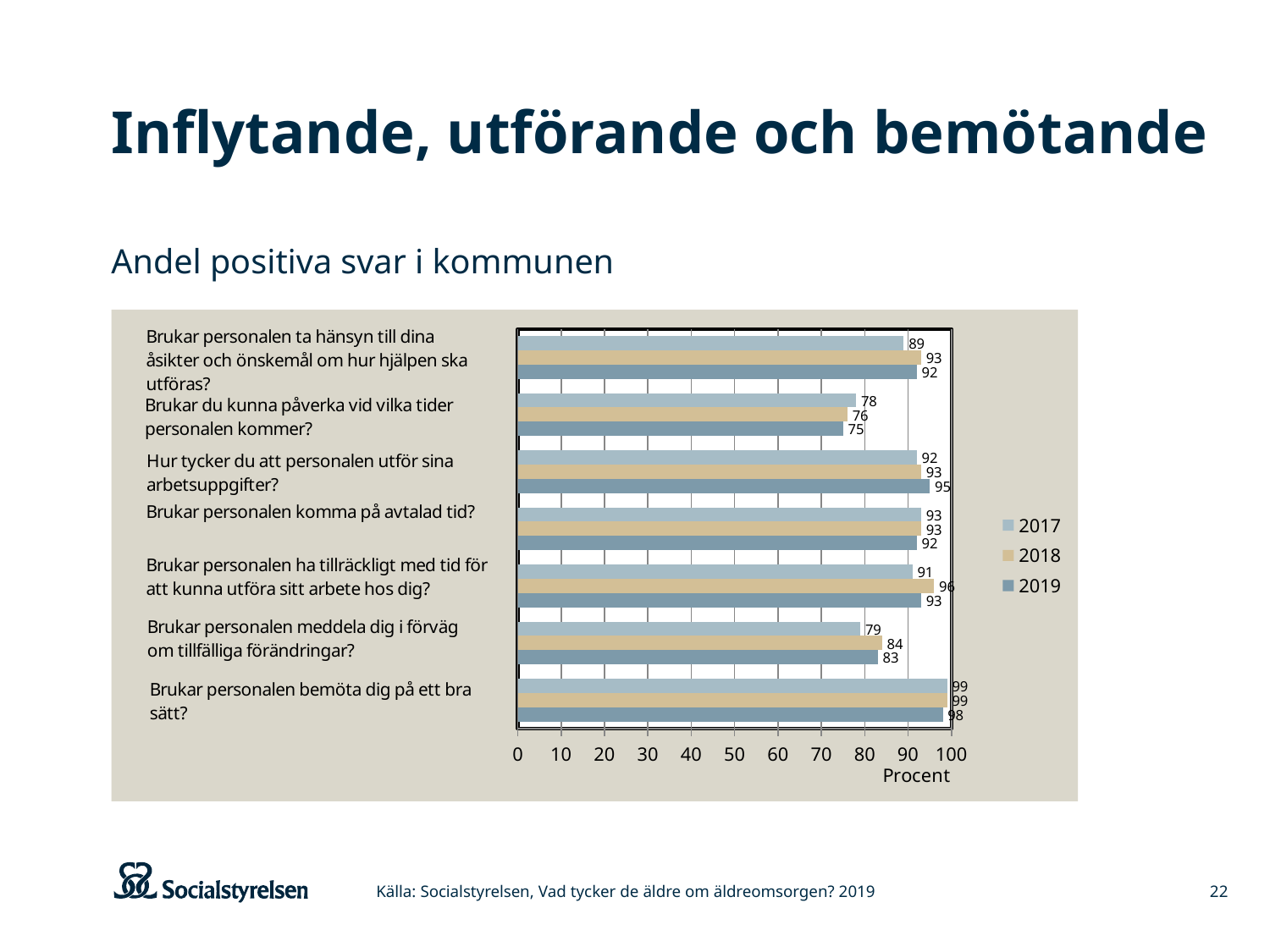
What kind of chart is shown on the slide? bar chart Which question has the lowest 2017 value? Brukar du kunna påverka vid vilka tider personalen kommer? What is the 2018 value for "Brukar personalen ha tillräckligt med tid för att kunna utföra sitt arbete hos dig?"? 96 Is the 2019 value for "Brukar personalen meddela dig i förväg om tillfälliga förändringar?" greater or less than 90? less What is the 2019 value for "Brukar du kunna påverka vid vilka tider personalen kommer?"? 75 For "Hur tycker du att personalen utför sina arbetsuppgifter?", which year has the larger value, 2017 or 2019? 2019 Which question has the highest 2019 value? Brukar personalen bemöta dig på ett bra sätt? How many series does the legend list? 3 What is the label on the horizontal axis of the chart? Procent What is the difference between the 2018 and 2017 values for "Brukar personalen meddela dig i förväg om tillfälliga förändringar?"? 5 What is the 2017 value for "Brukar personalen meddela dig i förväg om tillfälliga förändringar?"? 79 How many questions (categories) are shown in the chart? 7